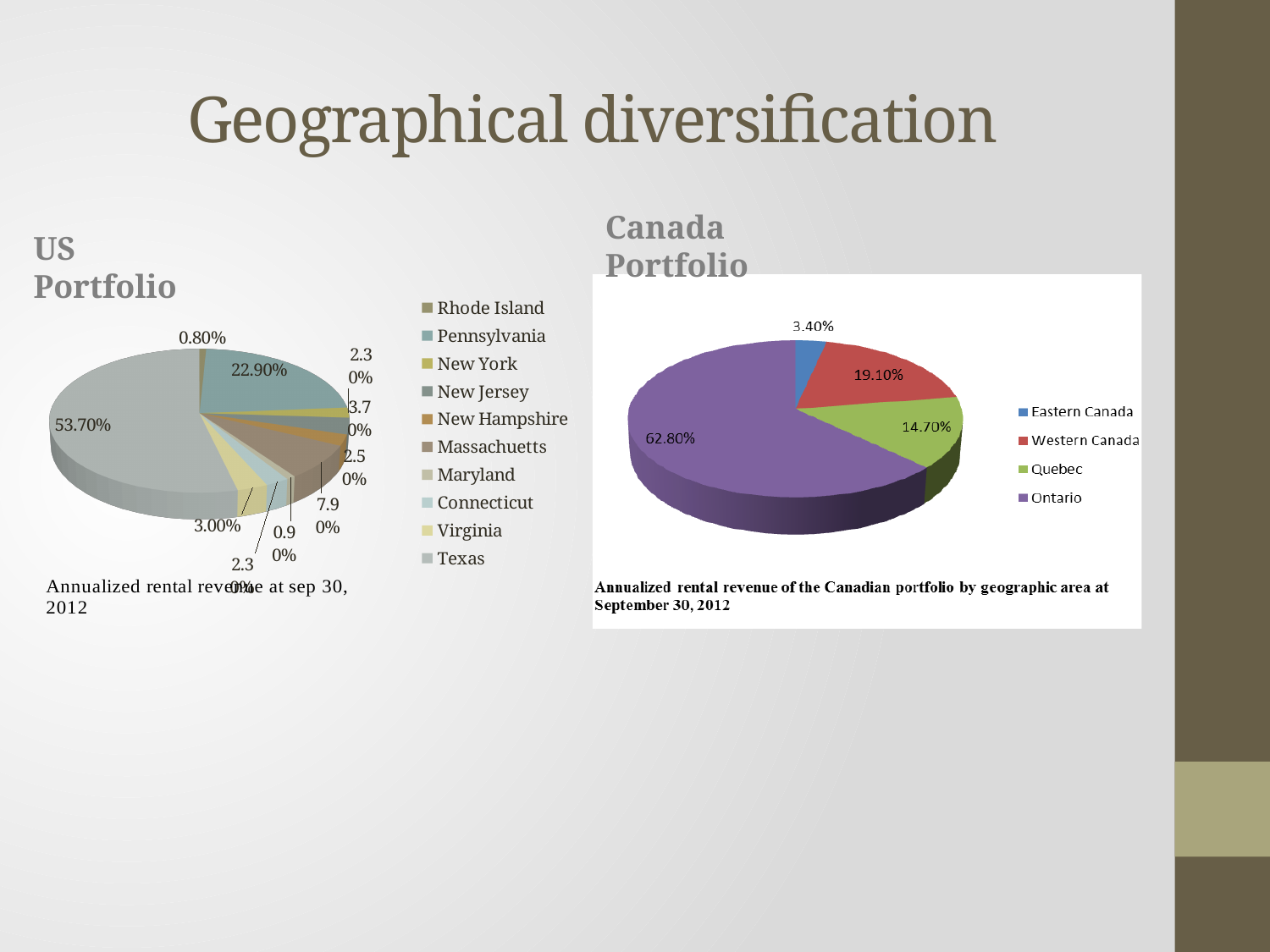
How many regions does the Canada Portfolio chart's legend list? 4 In the Canada Portfolio chart, which region has the smallest share? Eastern Canada How many states does the US Portfolio chart's legend list? 10 In the Canada Portfolio chart, which is larger, Western Canada or Quebec? Western Canada In the US Portfolio chart, what is the value of the largest slice? 53.70% In the Canada Portfolio chart, which region has the largest share? Ontario In the Canada Portfolio chart, what is the value for Western Canada? 19.10% What type of chart is the US Portfolio chart? Pie chart In the Canada Portfolio chart, what share of annualized rental revenue comes from Ontario? 62.80% In the Canada Portfolio chart, what is the value for Eastern Canada? 3.40% In the Canada Portfolio chart, what is the value for Quebec? 14.70% In the Canada Portfolio chart, what is the difference in percentage points between Western Canada and Quebec? 4.40%